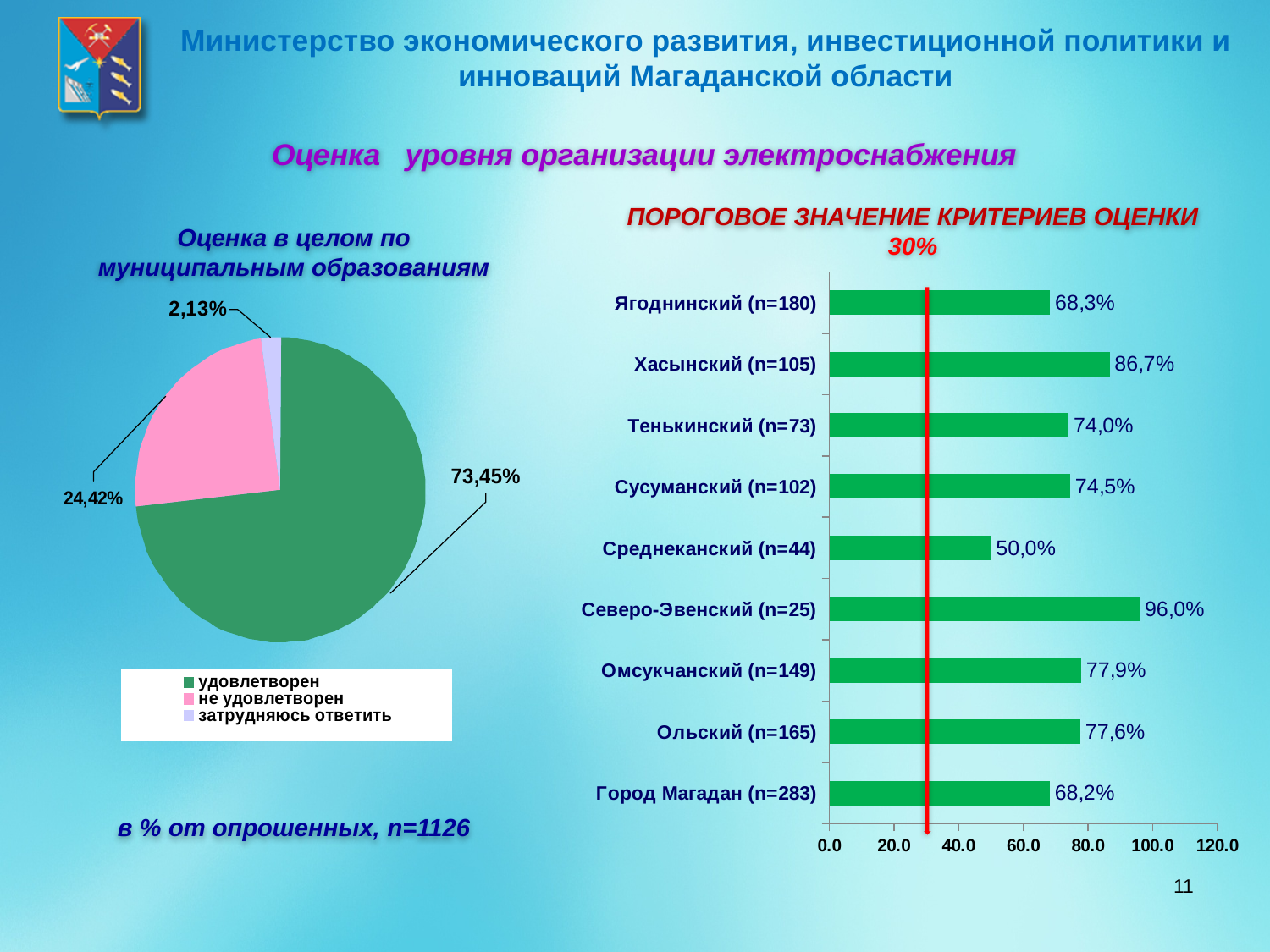
In the bar chart on the right, what is the difference between the values for Северо-Эвенский (n=25) and Город Магадан (n=283)? 27,8% In the pie chart on the left, how many entries does the legend list? 3 In the pie chart on the left, what is the difference between the "удовлетворен" and "не удовлетворен" shares? 49,03% In the bar chart on the right, which municipality has the highest value? Северо-Эвенский (n=25) In the pie chart on the left, what share of respondents answered "затрудняюсь ответить"? 2,13% In the pie chart on the left, which answer has the smallest slice? затрудняюсь ответить In the bar chart on the right, how many municipalities are shown? 9 In the bar chart on the right, what is the value for Хасынский (n=105)? 86,7% In the bar chart on the right, what is the value for Среднеканский (n=44)? 50,0% In the bar chart on the right, which municipality has the lowest value? Среднеканский (n=44) What kind of chart is shown on the right side of the slide? bar chart In the pie chart on the left, what share of respondents answered "удовлетворен"? 73,45%